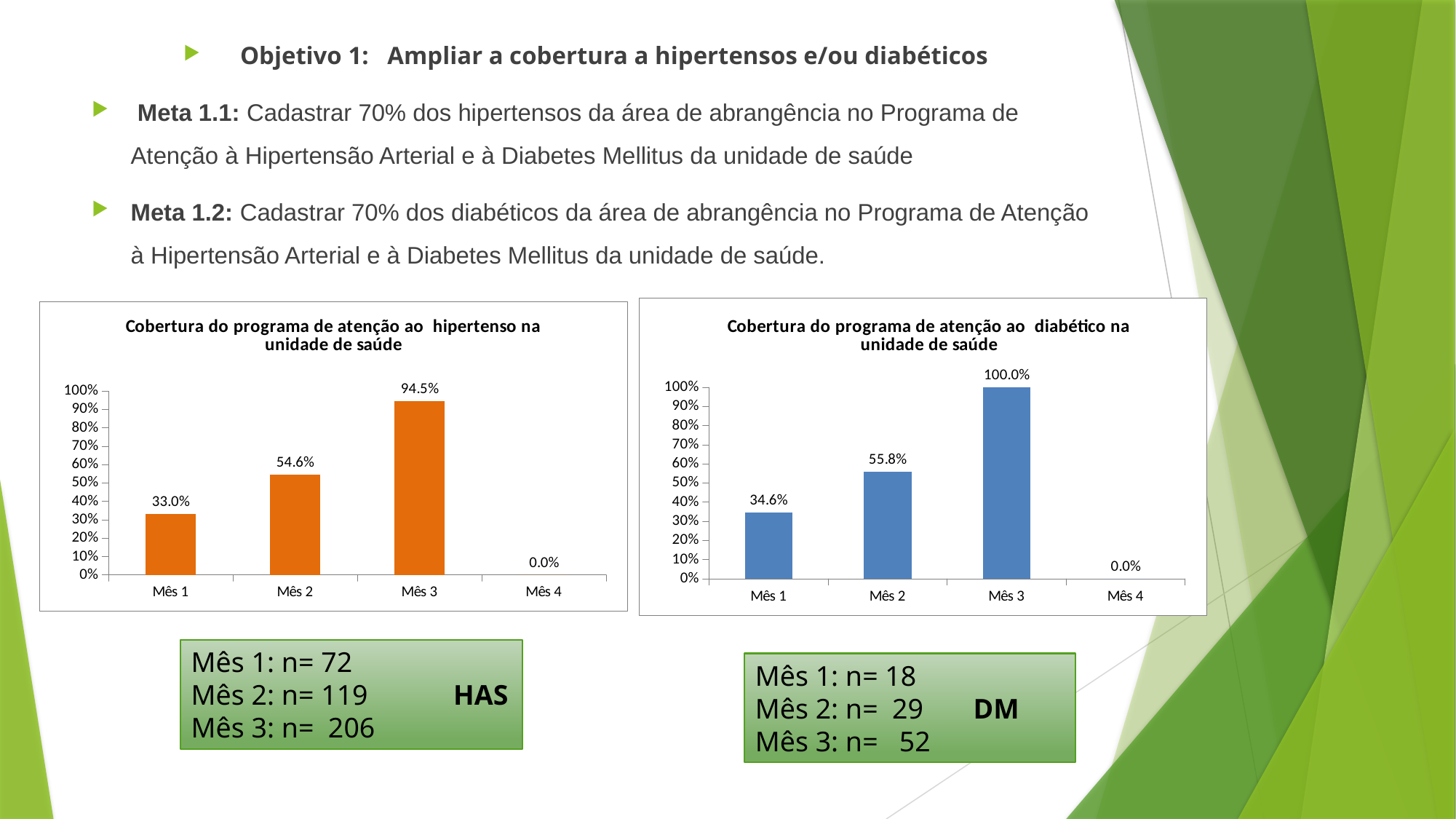
In the right chart (Cobertura do programa de atenção ao diabético na unidade de saúde), what is the value for Mês 1? 34.6% In the left chart (hipertenso), do the values rise or fall from Mês 1 to Mês 3? rise In the right chart (diabético), which month has the lowest value? Mês 4 In the left chart (Cobertura do programa de atenção ao hipertenso na unidade de saúde), what is the value for Mês 2? 54.6% In the left chart (hipertenso), which month has the highest value? Mês 3 How many categories are shown on the x axis of the left chart (hipertenso)? 4 What kind of chart is the right chart (diabético)? bar chart In the right chart (diabético), which is larger, the value for Mês 2 or Mês 3? Mês 3 What colour are the bars in the right chart (diabético)? blue In the left chart (hipertenso), what is the difference between the values for Mês 3 and Mês 1? 61.5% In the left chart (hipertenso), is the value for Mês 3 greater or less than 90%? greater In the right chart (diabético), what is the difference between the values for Mês 3 and Mês 2? 44.2%